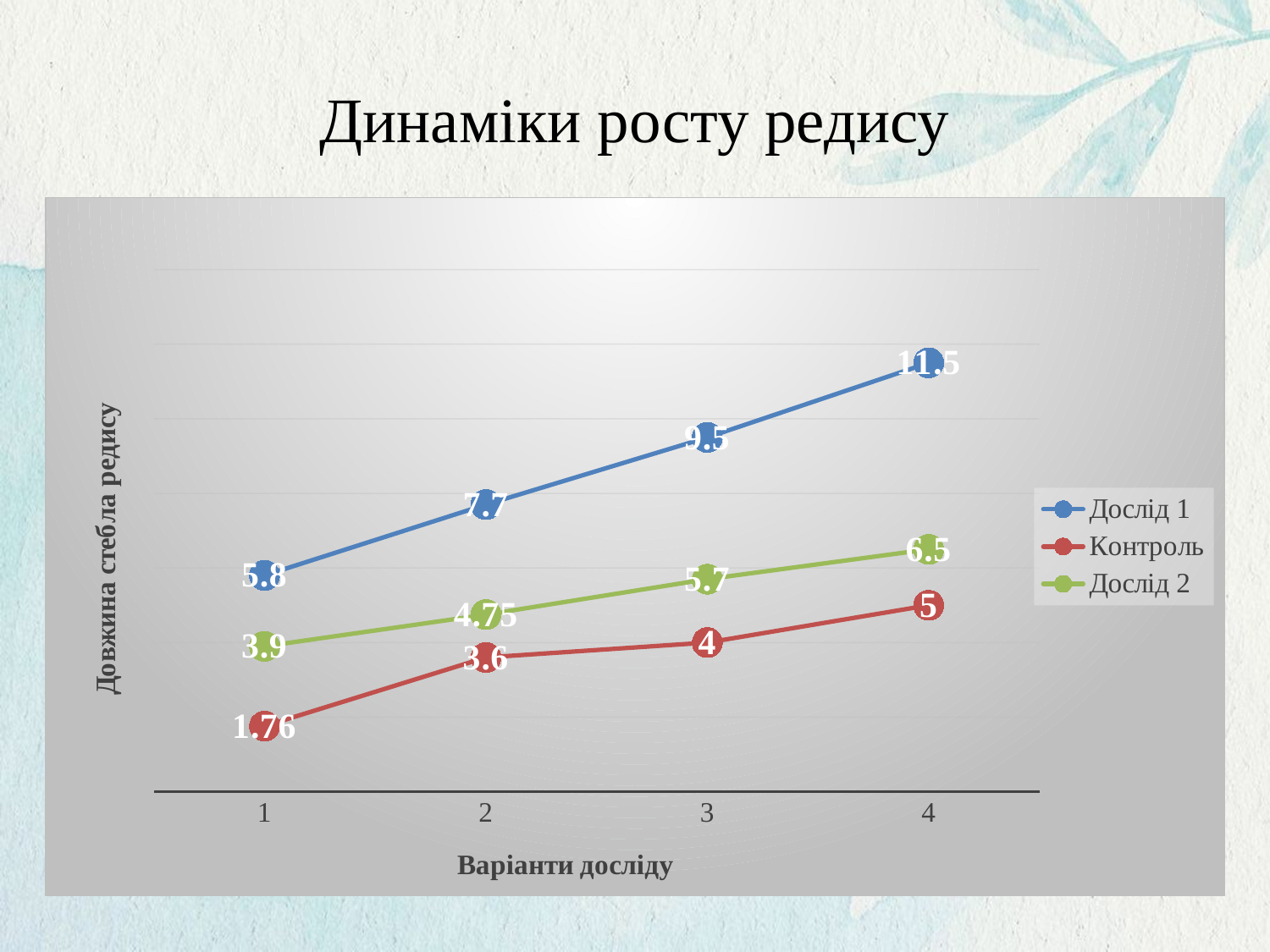
What kind of chart is shown on the slide? line chart What is the title of the chart on the slide? Динаміки росту редису What is the value of Контроль at variant 1? 1.76 Do the values of Контроль rise or fall from variant 1 to variant 4? rise Which is larger at variant 1: Дослід 2 or Контроль? Дослід 2 Which series has the lowest value at variant 2? Контроль What is the value of Дослід 2 at variant 2? 4.75 How many series does the legend list? 3 How many points are plotted along the x axis for each series? 4 Which series has the highest value at variant 3? Дослід 1 What is the difference between Дослід 1 and Контроль at variant 4? 6.5 What is the value of Дослід 1 at variant 4? 11.5